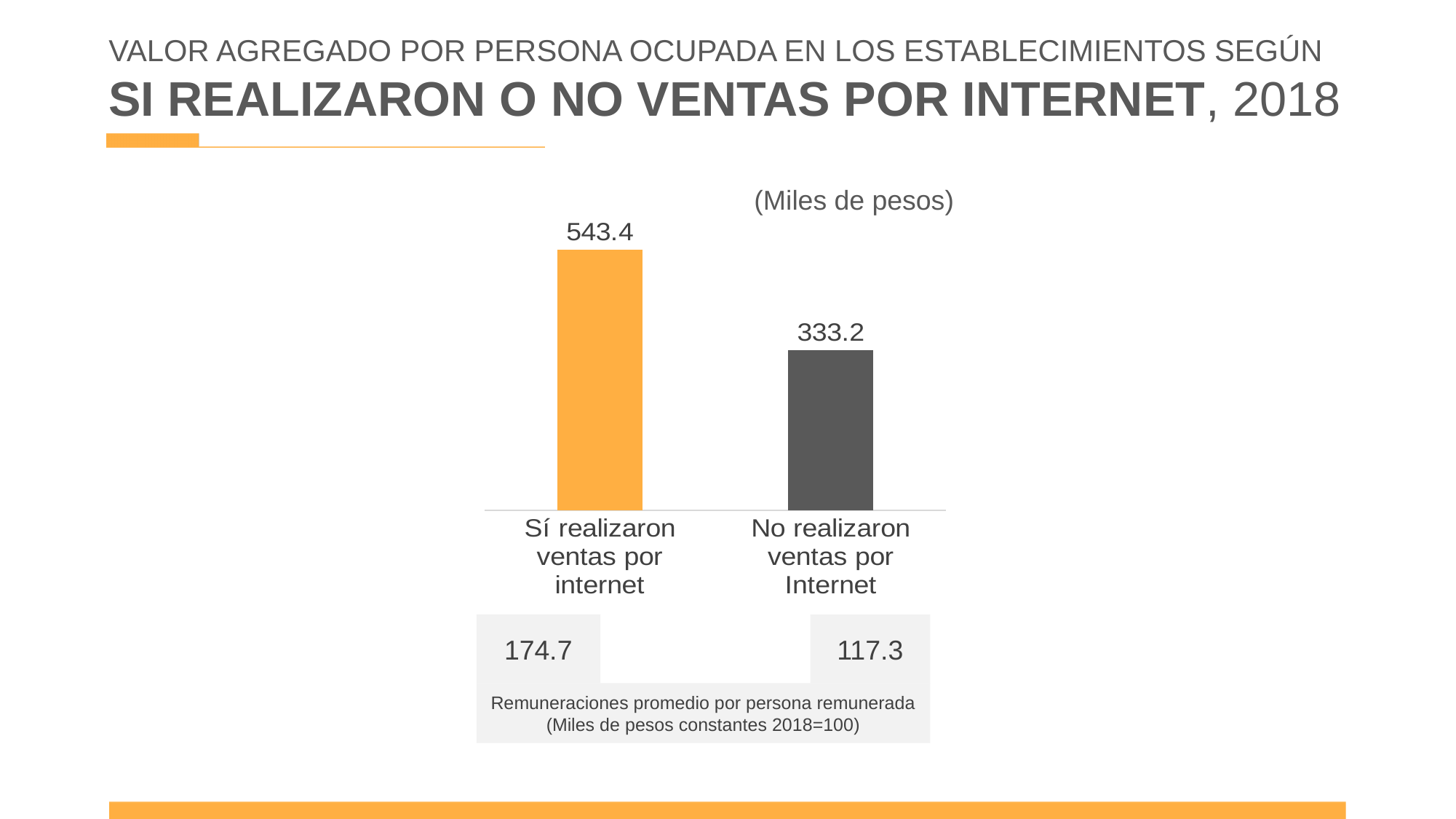
What colour is the bar for 'Sí realizaron ventas por internet'? Orange What is the 'Remuneraciones promedio por persona remunerada' value shown for 'No realizaron ventas por Internet'? 117.3 Which is larger, the value for 'Sí realizaron ventas por internet' or for 'No realizaron ventas por Internet'? Sí realizaron ventas por internet Which category has the highest value? Sí realizaron ventas por internet What is the value for 'No realizaron ventas por Internet'? 333.2 What is the difference between the values for 'Sí realizaron ventas por internet' and 'No realizaron ventas por Internet'? 210.2 How many categories are shown in the chart? 2 What is the 'Remuneraciones promedio por persona remunerada' value shown for 'Sí realizaron ventas por internet'? 174.7 Which category has the lowest value? No realizaron ventas por Internet What is the value for 'Sí realizaron ventas por internet'? 543.4 What unit is shown above the chart? Miles de pesos What kind of chart is shown on the slide? Bar chart